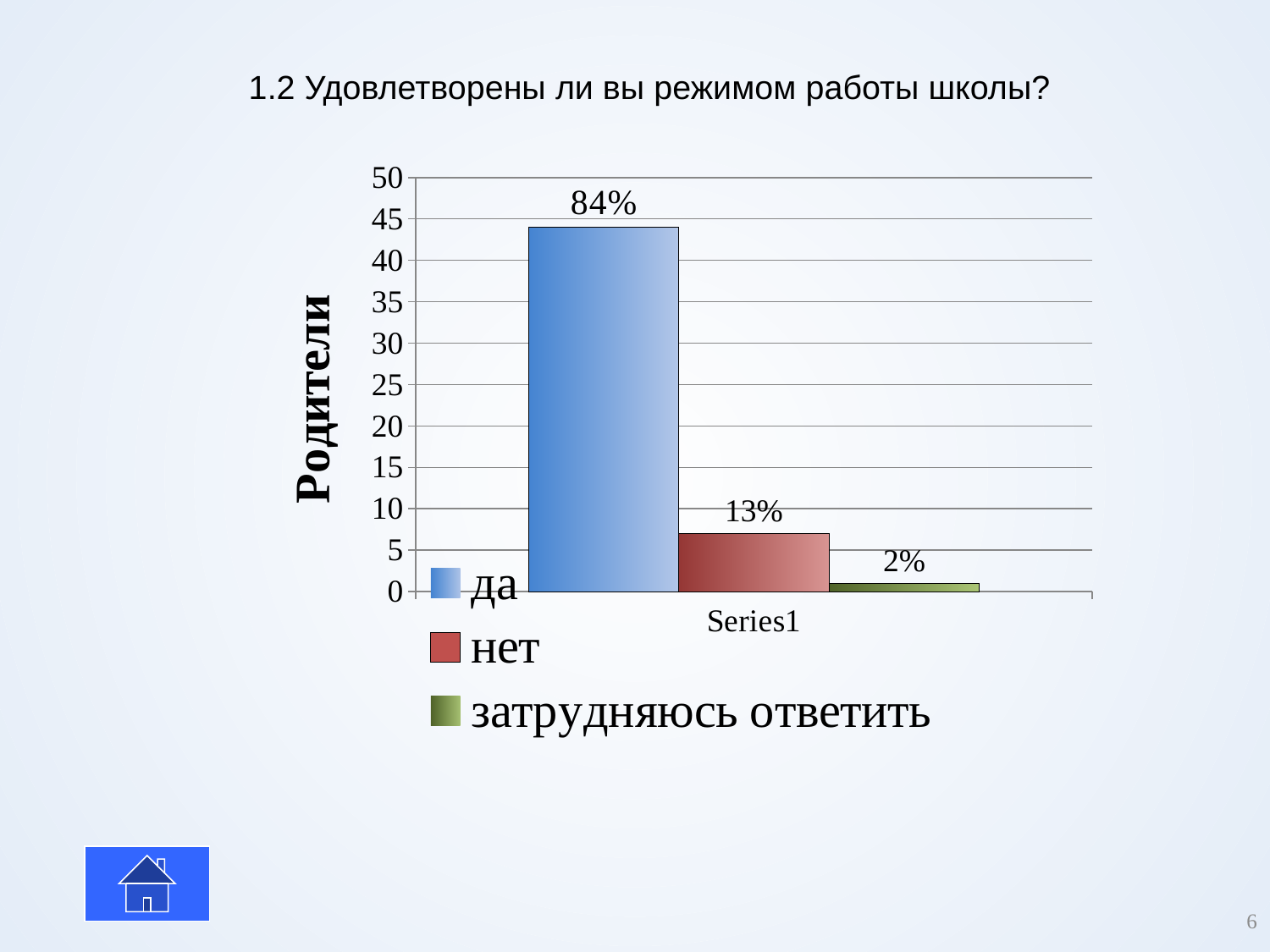
Which is larger, the bar for "нет" or the bar for "затрудняюсь ответить"? нет What kind of chart is shown on the slide? bar chart What is the data label on the bar for "нет"? 13% What is the difference in percentage points between the labels for "да" and "нет"? 71% Which answer option has the lowest bar? затрудняюсь ответить What is the data label on the bar for "да"? 84% What is the data label on the bar for "затрудняюсь ответить"? 2% What is the label on the vertical axis of the chart? Родители Is the bar for "да" greater or less than 40 on the vertical axis? greater Is the bar for "нет" greater or less than 10 on the vertical axis? less How many series does the legend list? 3 Which answer option has the highest bar? да